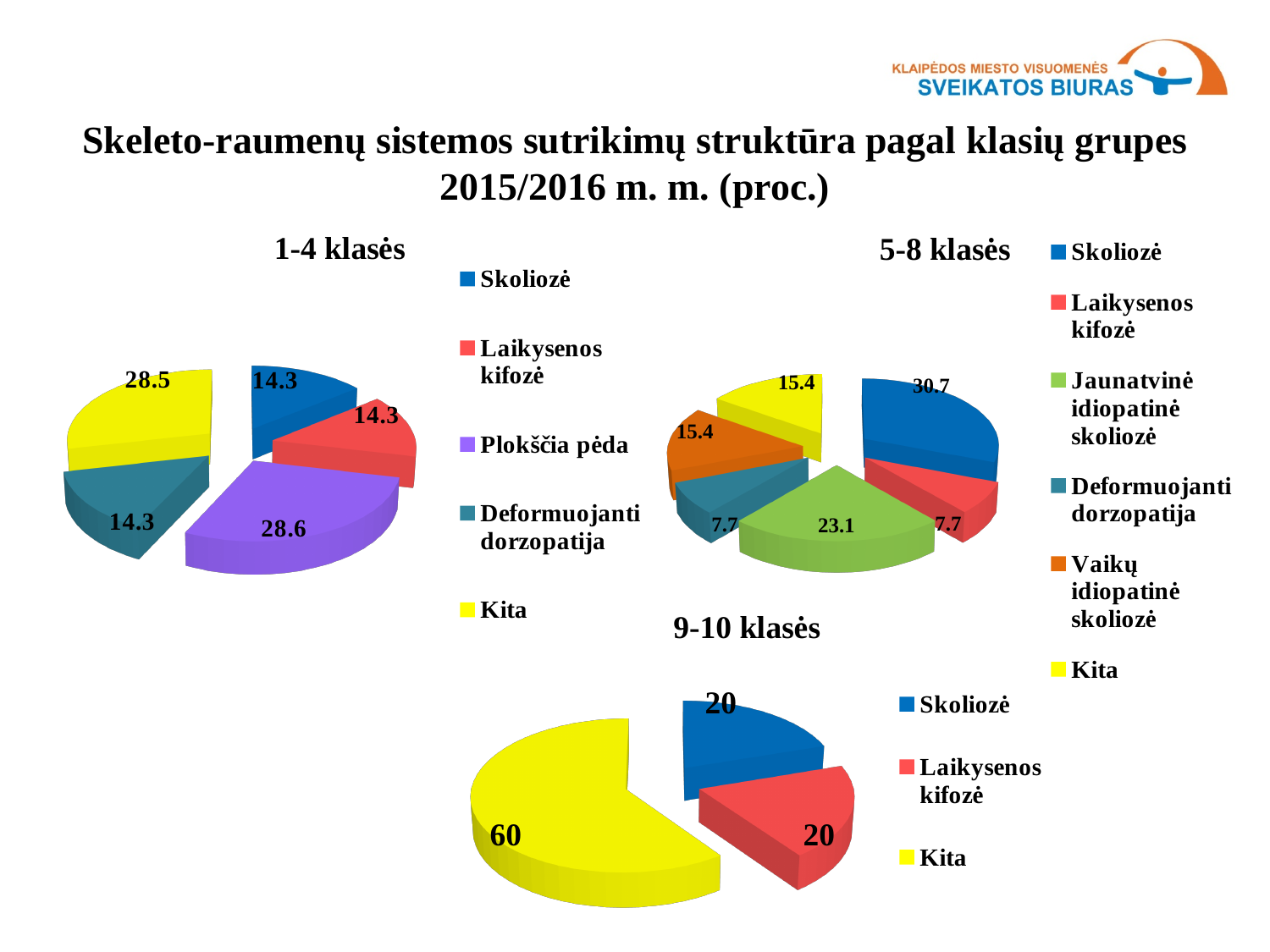
In the "5-8 klasės" chart, which category has the highest value? Skoliozė In the "1-4 klasės" chart, what is the value for Plokščia pėda? 28.6 In the "5-8 klasės" chart, what is the difference between Skoliozė and Jaunatvinė idiopatinė skoliozė? 7.6 In the "5-8 klasės" chart, what is the value for Jaunatvinė idiopatinė skoliozė? 23.1 In the "9-10 klasės" chart, what is the value for Kita? 60 How many categories does the "5-8 klasės" chart show? 6 In the "5-8 klasės" chart, what is the value for Skoliozė? 30.7 In the "9-10 klasės" chart, which category has the highest value? Kita In the "9-10 klasės" chart, what is the difference between Kita and Skoliozė? 40 In the "1-4 klasės" chart, which is larger: Plokščia pėda or Skoliozė? Plokščia pėda In the "1-4 klasės" chart, what is the value for Kita? 28.5 What kind of chart is the "9-10 klasės" chart? Pie chart